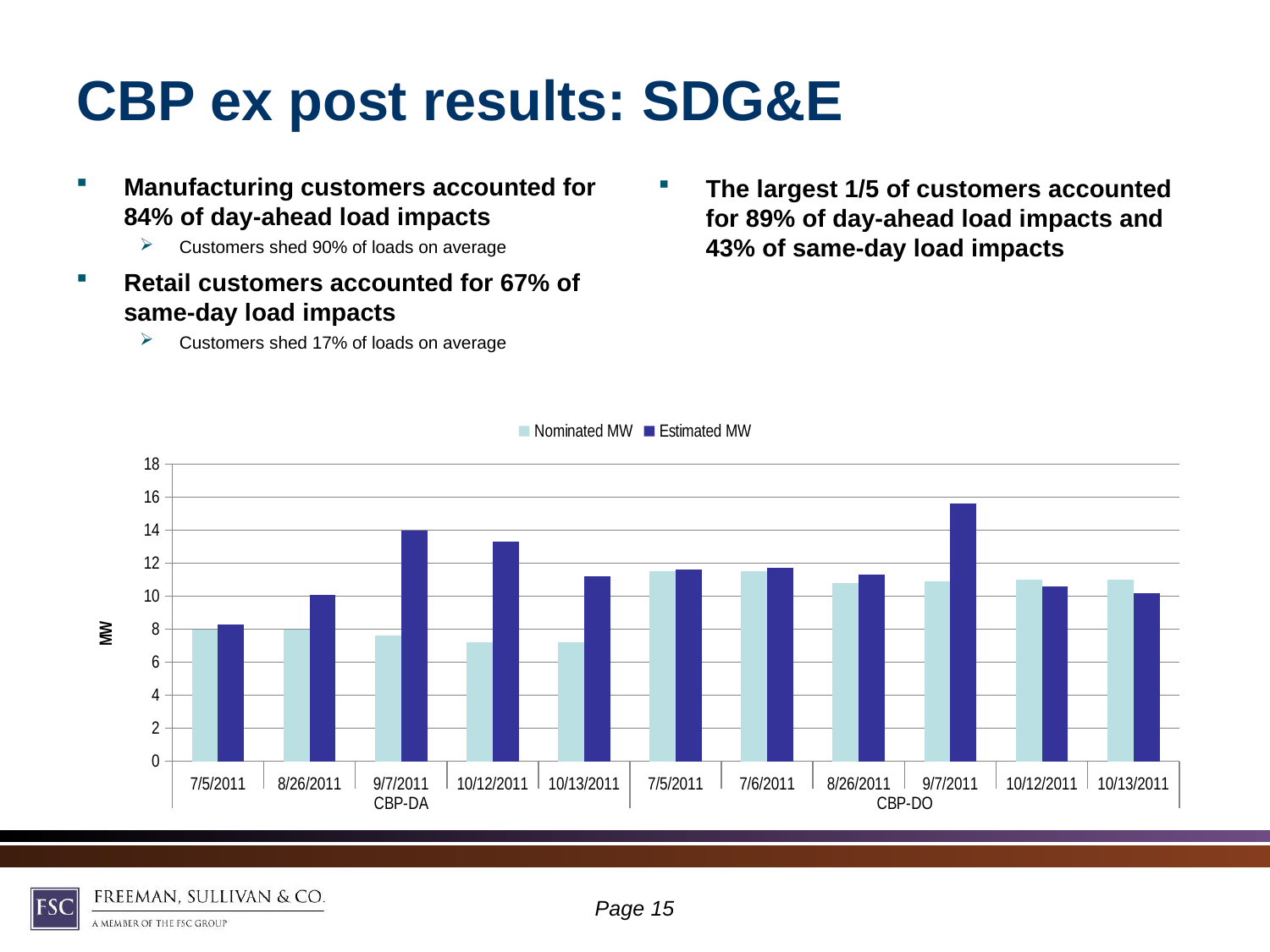
What are the two series named in the chart legend? Nominated MW and Estimated MW For 10/13/2011 under CBP-DO, which is larger: Nominated MW or Estimated MW? Nominated MW How many series does the chart legend list? 2 What type of chart is shown on the slide? Bar chart For 10/12/2011 under CBP-DA, which is larger: Nominated MW or Estimated MW? Estimated MW Is the Estimated MW value for 9/7/2011 under CBP-DO greater or less than 14? greater What is the label on the chart's vertical axis? MW Is the Nominated MW value for 10/13/2011 under CBP-DA greater or less than 8? less Is the Estimated MW value for 9/7/2011 under CBP-DA greater or less than 12? greater How many date categories are plotted in the chart in total? 11 How many dates are plotted under the CBP-DA group? 5 Which date has the highest Estimated MW bar in the chart? 9/7/2011 (CBP-DO)